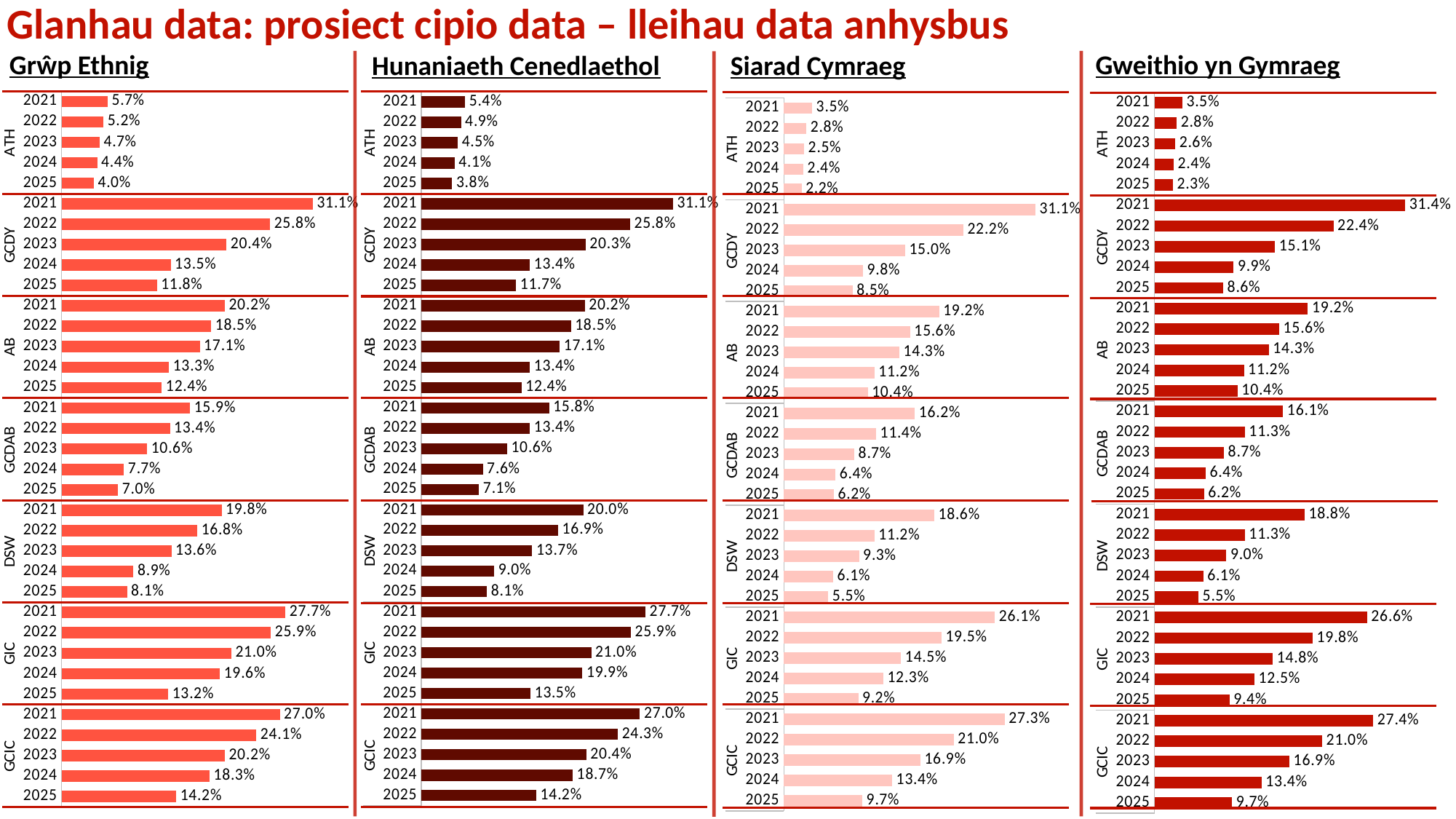
In the Siarad Cymraeg chart, what is the difference between the GCDY values for 2021 and 2025? 22.6% In the Hunaniaeth Cenedlaethol chart, which is larger: the GIC value for 2022 or the GCIC value for 2022? GIC 2022 (25.9%) What kind of chart is the Gweithio yn Gymraeg chart? bar chart How many years are shown for each group in the Siarad Cymraeg chart? 5 In the Gweithio yn Gymraeg chart, which year has the highest value for GCDY? 2021 In the Grŵp Ethnig chart, what is the value for GCDY in 2021? 31.1% In the Grŵp Ethnig chart, which year has the lowest value for ATH? 2025 How many charts are shown on the slide? 4 In the Siarad Cymraeg chart, what is the value for GIC in 2025? 9.2% In the Gweithio yn Gymraeg chart, what is the value for GCIC in 2022? 21.0% In the Hunaniaeth Cenedlaethol chart, what is the value for DSW in 2023? 13.7% In the Grŵp Ethnig chart, do the values for AB rise or fall from 2021 to 2025? fall